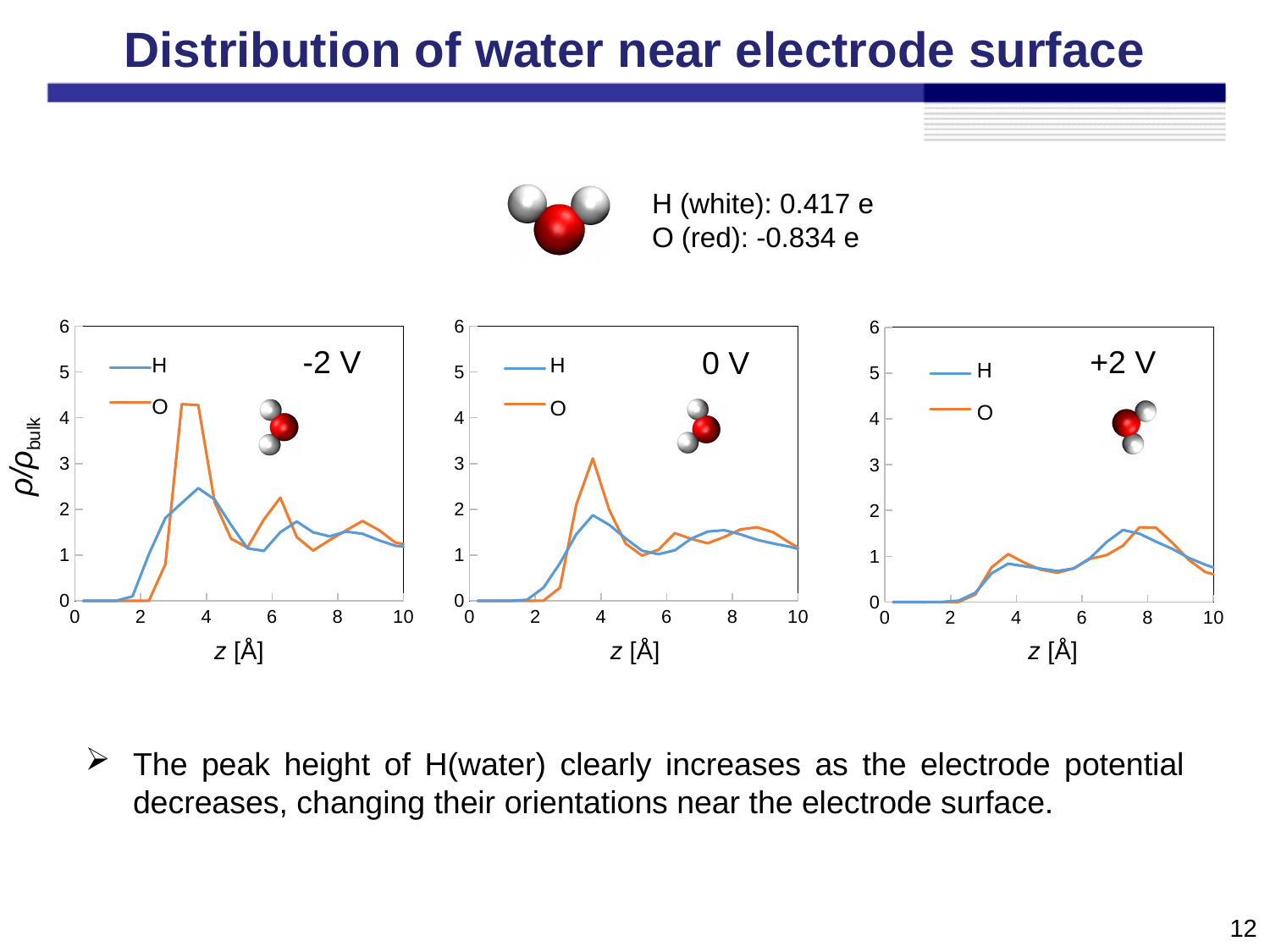
In the -2 V chart, which series reaches the higher peak, H or O? O In the 0 V chart, is the peak value of the O series greater or less than 2? greater In the +2 V chart, which colour is used for the O series? orange How many charts are shown on the slide? 3 What kind of chart is the -2 V chart? line chart In the +2 V chart, is the peak value of the H series greater or less than 2? less In the -2 V chart, is the peak value of the H series greater or less than 2? greater In the 0 V chart, which series reaches the higher peak, H or O? O How many series does the legend of the 0 V chart list? 2 What is the x-axis label of the 0 V chart? z [Å]